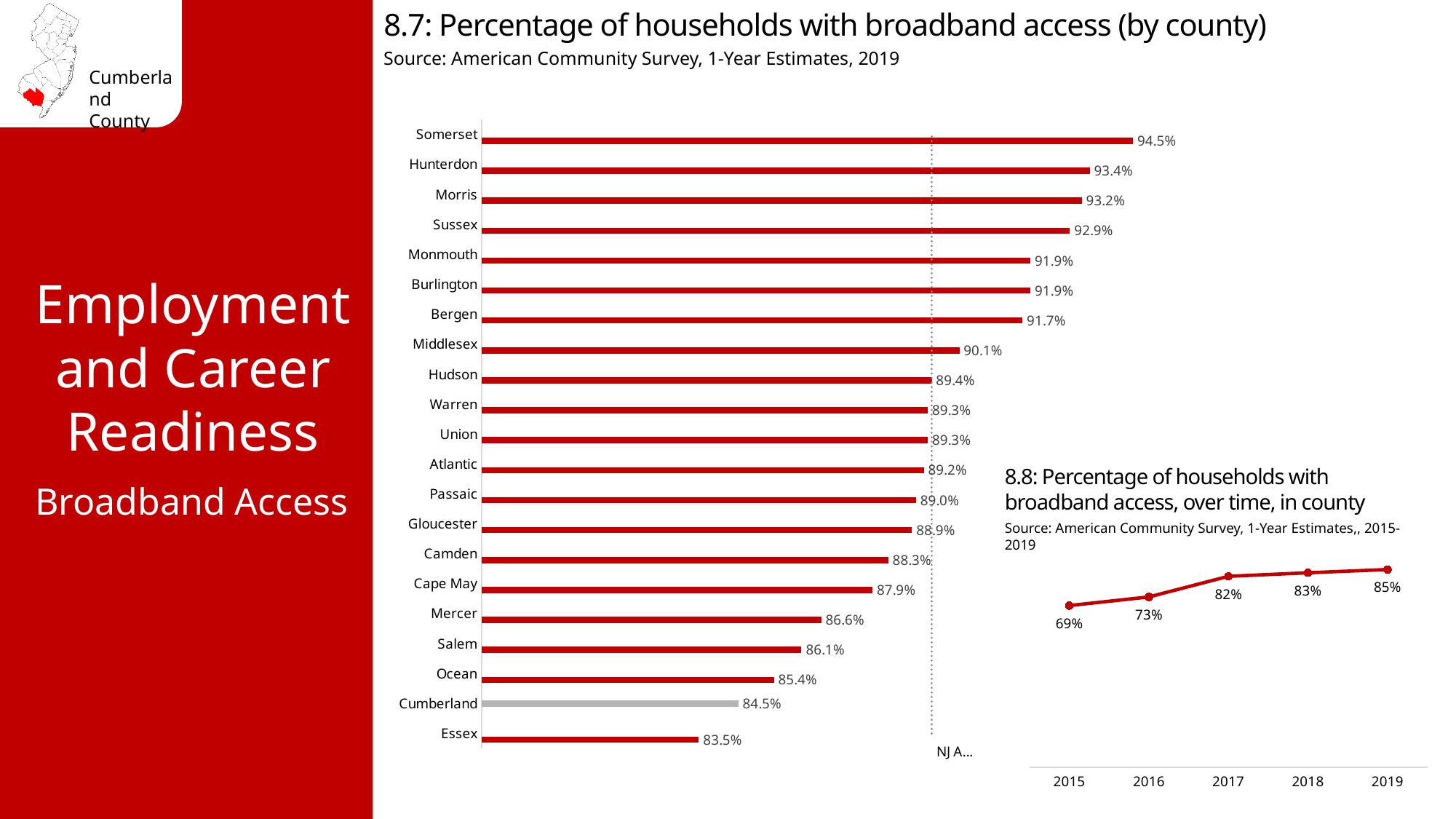
In the chart '8.7: Percentage of households with broadband access (by county)', which county has the lowest percentage? Essex In the chart '8.8: Percentage of households with broadband access, over time, in county', what is the difference between 2019 and 2015? 16% In the chart '8.8: Percentage of households with broadband access, over time, in county', do the values rise or fall from 2015 to 2019? Rise In the chart '8.8: Percentage of households with broadband access, over time, in county', what is the value for 2017? 82% In the chart '8.7: Percentage of households with broadband access (by county)', what is the value for Middlesex? 90.1% How many data points are plotted in the chart '8.8: Percentage of households with broadband access, over time, in county'? 5 In the chart '8.7: Percentage of households with broadband access (by county)', what is the difference between Somerset and Essex? 11.0% In the chart '8.7: Percentage of households with broadband access (by county)', which county has the highest percentage? Somerset What kind of chart is '8.7: Percentage of households with broadband access (by county)'? Bar chart In the chart '8.7: Percentage of households with broadband access (by county)', what is the value for Cumberland? 84.5% In the chart '8.7: Percentage of households with broadband access (by county)', which is larger, Mercer or Salem? Mercer How many counties are shown in the chart '8.7: Percentage of households with broadband access (by county)'? 21